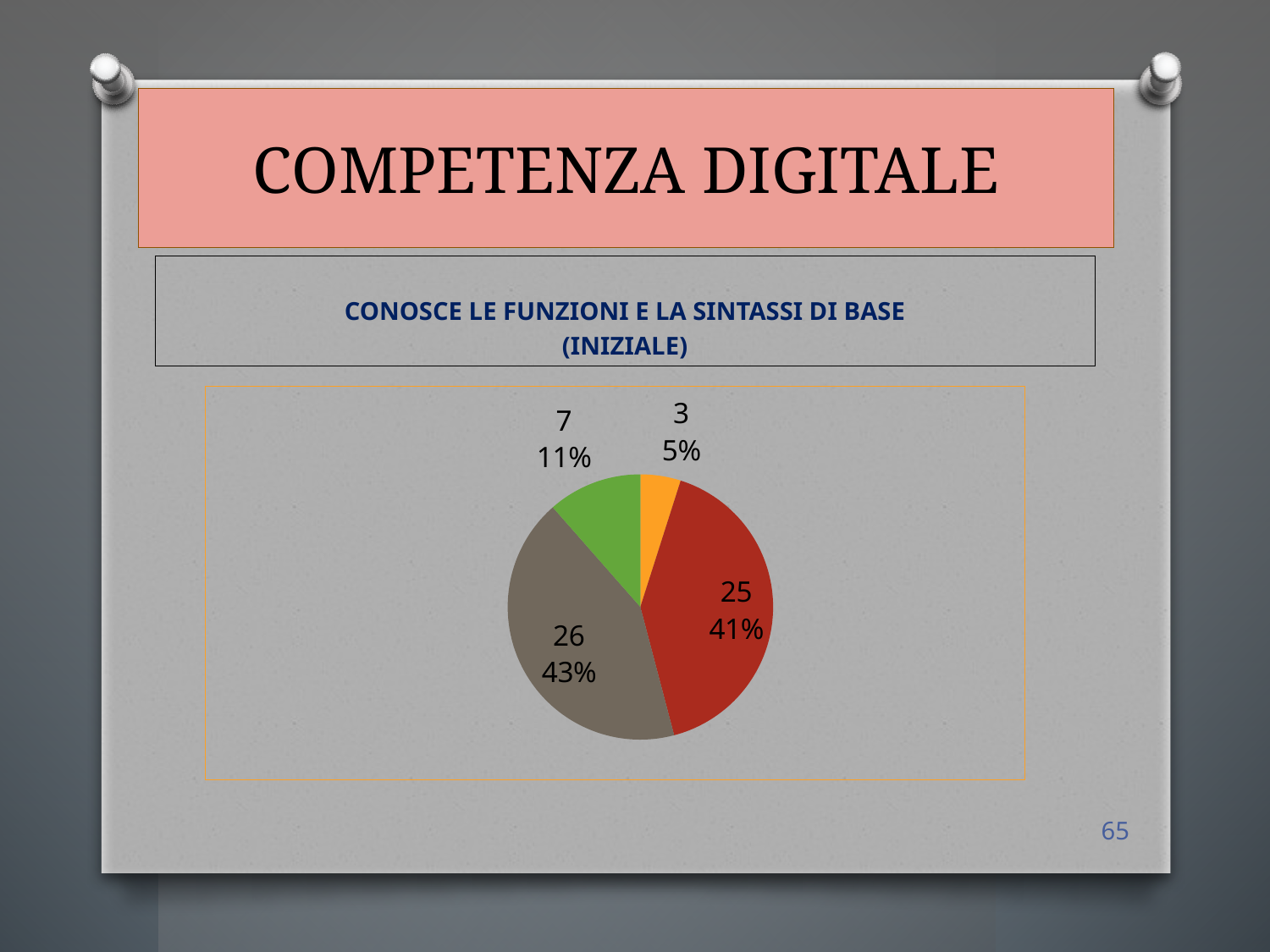
Which slice of the pie chart has the smallest value? the orange slice (3, 5%) Which slice of the pie chart has the largest value? the grey slice (26, 43%) What count is shown for the red slice of the pie chart? 25 Which is larger, the count for the green slice or the count for the orange slice? the green slice How many slices does the pie chart have? 4 What percentage is shown for the grey slice of the pie chart? 43% What is the difference between the counts of the grey slice and the red slice? 1 What is the total of all the counts shown on the pie chart? 61 What kind of chart is shown on the slide? pie chart What percentage is shown for the green slice of the pie chart? 11% What is the title shown above the pie chart? CONOSCE LE FUNZIONI E LA SINTASSI DI BASE (INIZIALE) What count is shown for the orange slice of the pie chart? 3